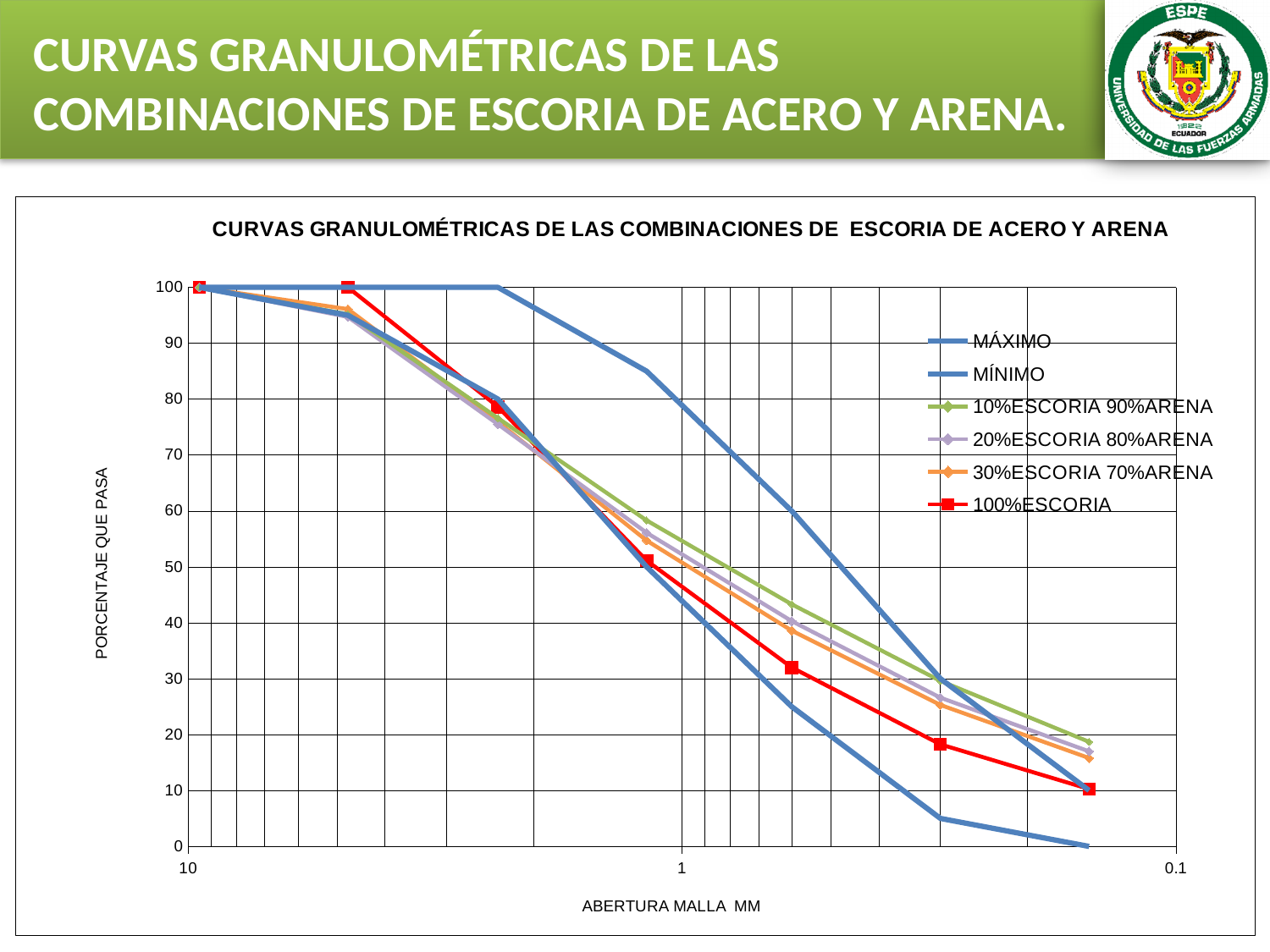
How many series does the legend list? 6 What is the title of the chart? CURVAS GRANULOMÉTRICAS DE LAS COMBINACIONES DE ESCORIA DE ACERO Y ARENA Is the value of the 100%ESCORIA series at its right-most point (near 0.1 mm) greater or less than 20? less Do the values of the 100%ESCORIA series rise or fall moving from left to right along the x axis? fall At the right end of the chart (near 0.1 mm), which series is higher, 10%ESCORIA 90%ARENA or 100%ESCORIA? 10%ESCORIA 90%ARENA What is the label of the vertical axis? PORCENTAJE QUE PASA What is the value of the 100%ESCORIA series at an abertura of 10 mm? 100 What kind of chart is shown on the slide? line chart